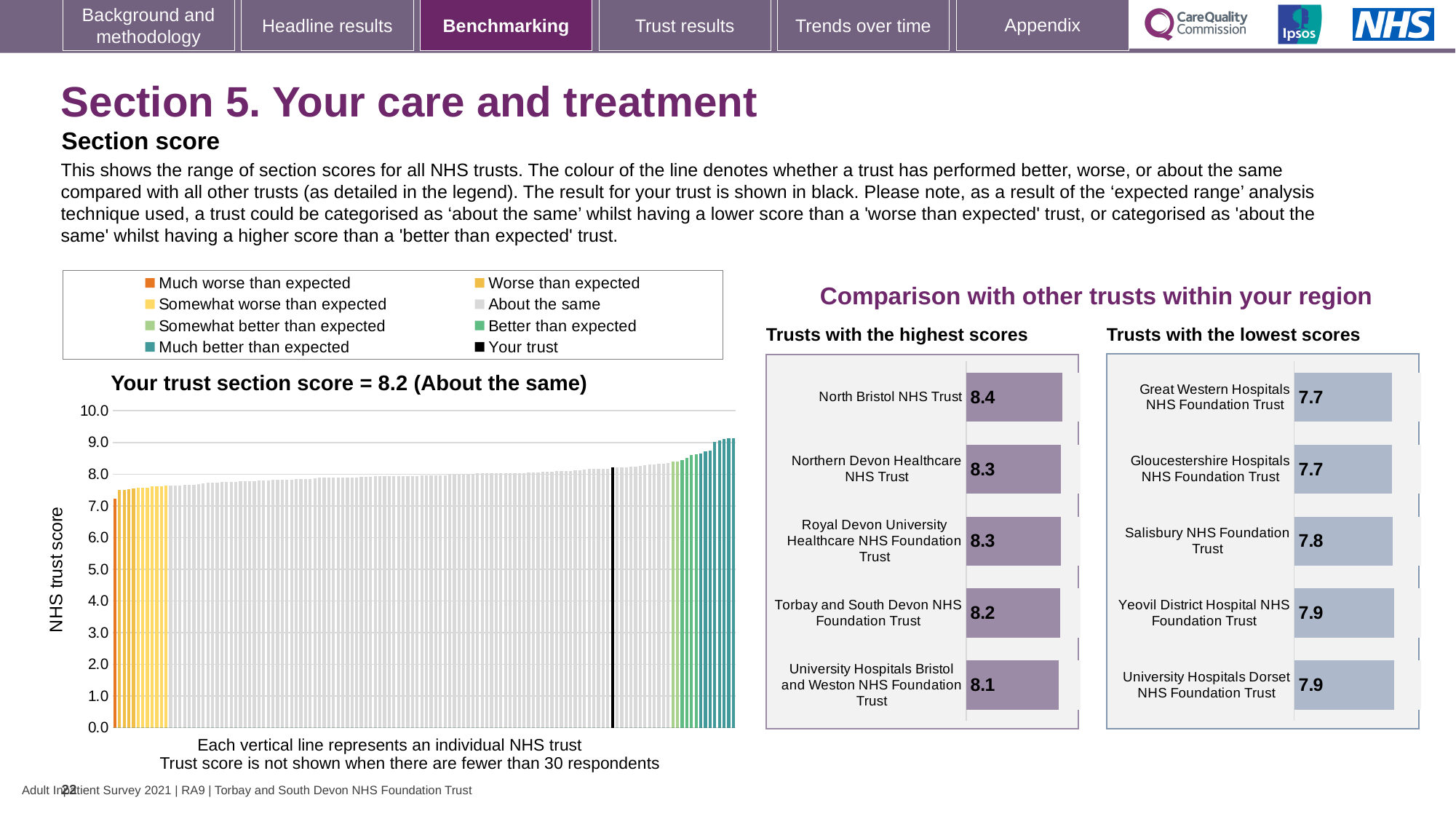
On the 'Trusts with the lowest scores' chart, what is the score for Salisbury NHS Foundation Trust? 7.8 On the 'Trusts with the lowest scores' chart, what is the difference between the scores of Salisbury NHS Foundation Trust and Great Western Hospitals NHS Foundation Trust? 0.1 On the 'Your trust section score' chart, do the trust scores rise or fall from left to right along the x axis? rise On the 'Trusts with the highest scores' chart, what is the difference between the scores of North Bristol NHS Trust and University Hospitals Bristol and Weston NHS Foundation Trust? 0.3 On the 'Your trust section score' chart, what is the section score for your trust? 8.2 On the 'Trusts with the lowest scores' chart, which has the larger score, Salisbury NHS Foundation Trust or Yeovil District Hospital NHS Foundation Trust? Yeovil District Hospital NHS Foundation Trust On the 'Your trust section score' chart, how many entries does the legend list? 8 On the 'Trusts with the highest scores' chart, which trust has the lowest score? University Hospitals Bristol and Weston NHS Foundation Trust On the 'Your trust section score' chart, what kind of chart is shown? bar chart On the 'Your trust section score' chart, what is the label of the y axis? NHS trust score On the 'Trusts with the highest scores' chart, how many trusts are shown? 5 On the 'Trusts with the highest scores' chart, what is the score for North Bristol NHS Trust? 8.4